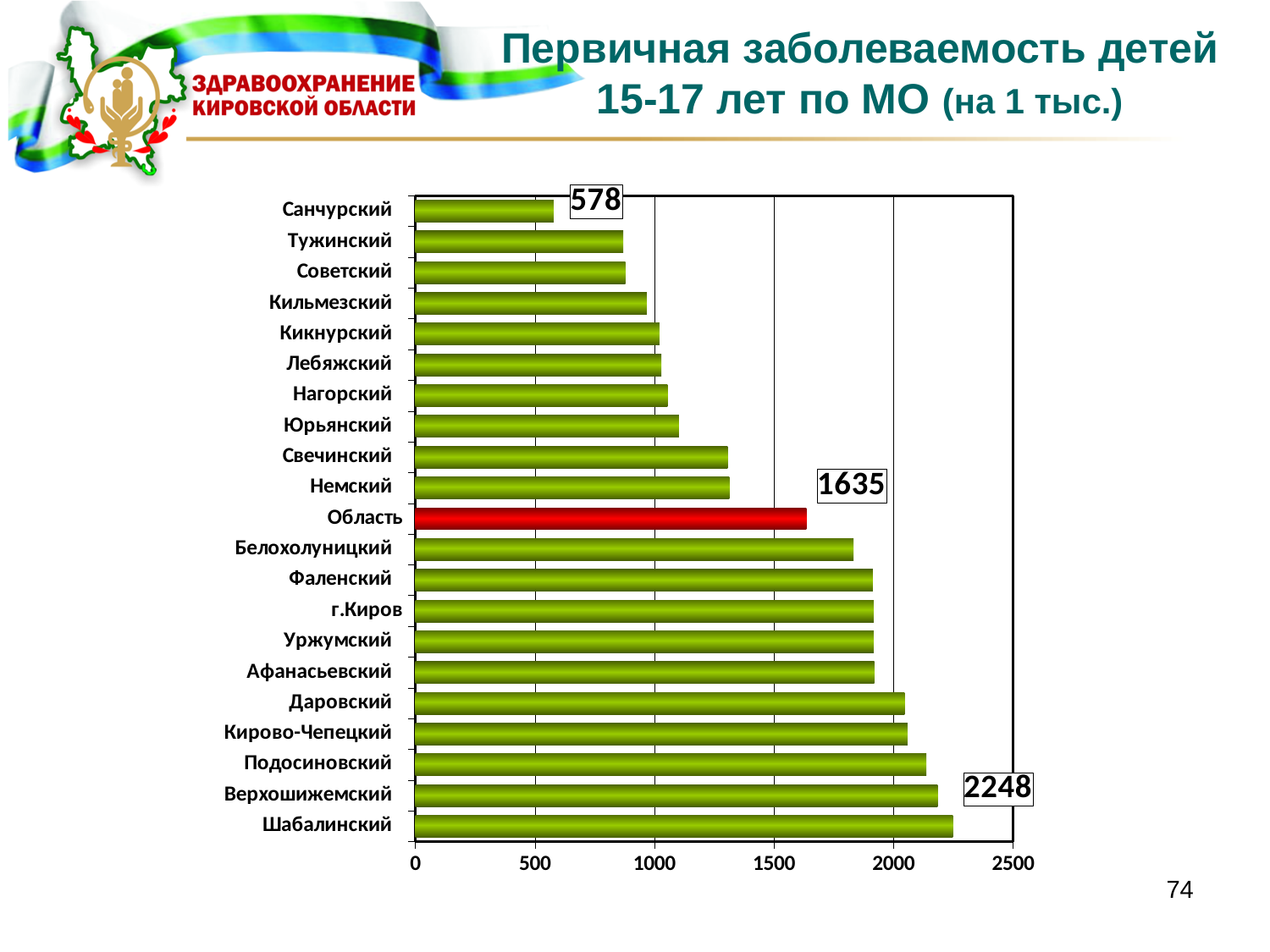
How many categories are shown on the chart? 21 What kind of chart is shown on the slide? bar chart What is the value for Область? 1635 Is the value for Тужинский greater or less than 1000? less What is the value for Шабалинский? 2248 Is the value for Свечинский greater or less than 1000? greater Which category has the lowest value? Санчурский What is the difference between the values for Шабалинский and Санчурский? 1670 Which is larger, the value for Область or the value for Санчурский? Область What is the difference between the values for Шабалинский and Область? 613 What is the value for Санчурский? 578 Which category has the highest value? Шабалинский